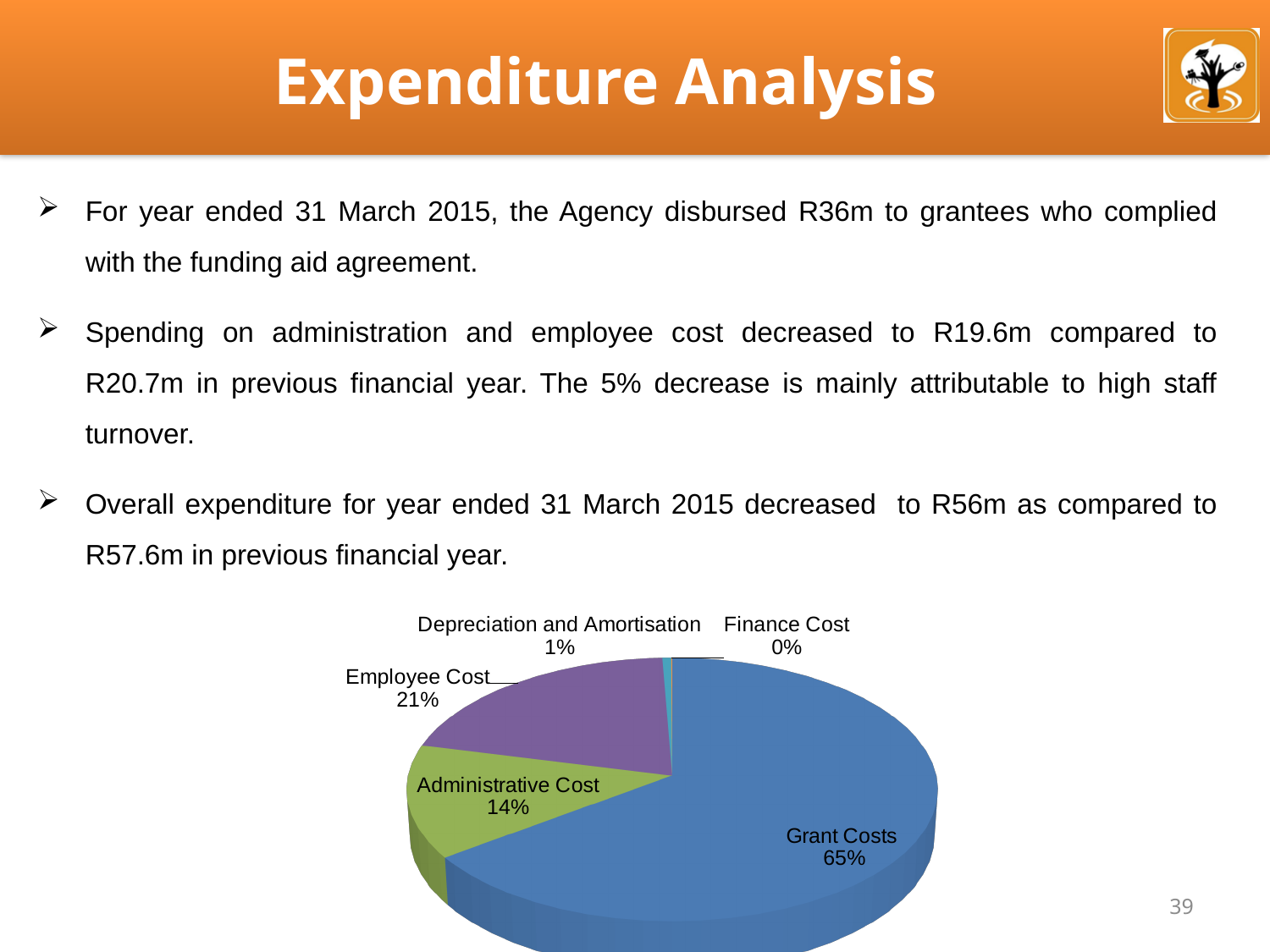
What share of expenditure is Grant Costs? 65% Which category has the smallest share of expenditure? Finance Cost What is the difference in percentage points between Employee Cost and Administrative Cost? 7 How many categories are shown in the pie chart? 5 What share of expenditure is Employee Cost? 21% What share of expenditure is Finance Cost? 0% What share of expenditure is Administrative Cost? 14% Which category has the largest share of expenditure? Grant Costs What kind of chart is shown on the slide? Pie chart What share of expenditure is Depreciation and Amortisation? 1% Which is larger, Employee Cost or Administrative Cost? Employee Cost What is the difference in percentage points between Grant Costs and Employee Cost? 44